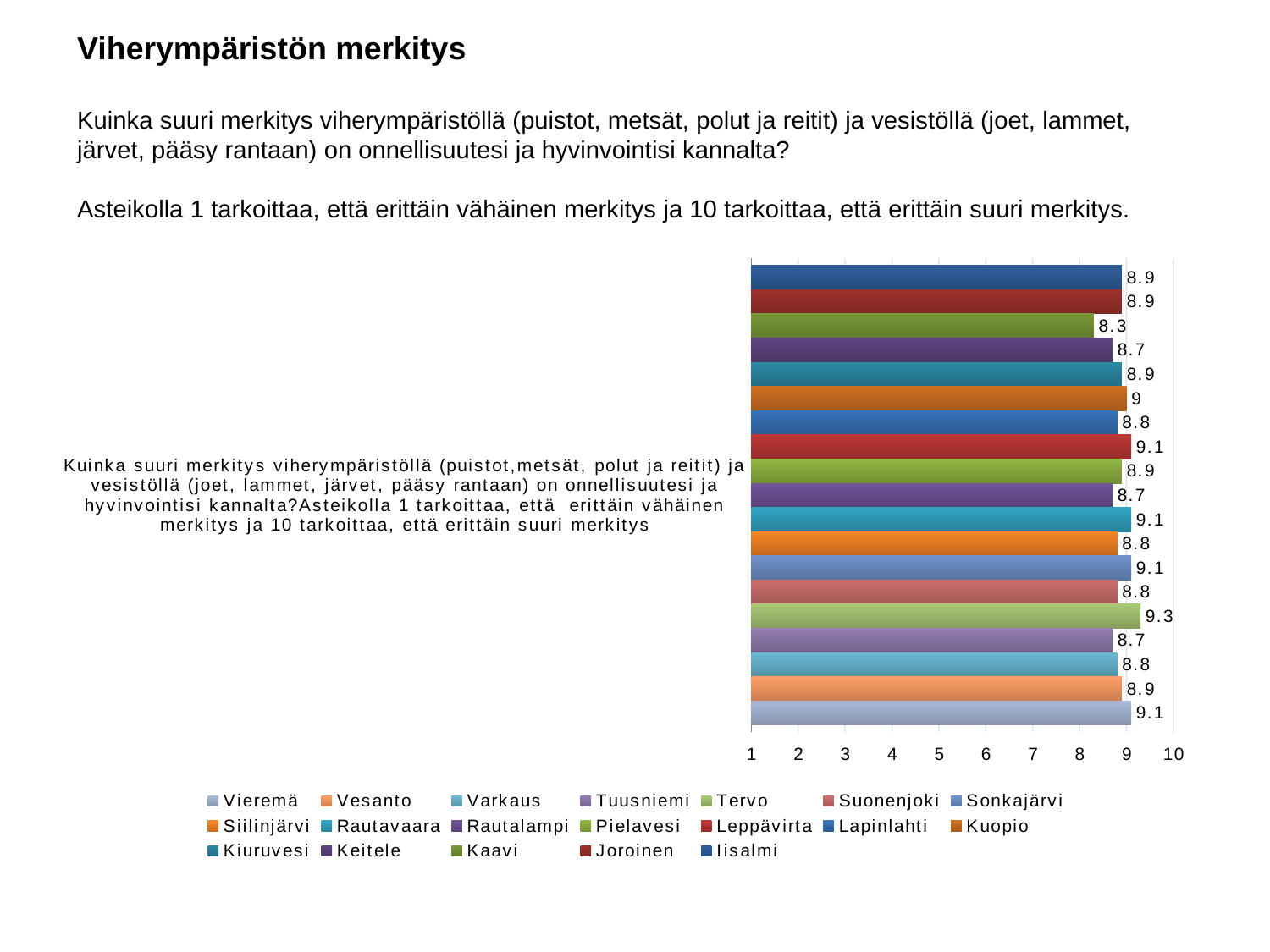
Which municipality has the highest value? Tervo What is the value for Iisalmi? 8.9 What is the difference between the values for Tervo and Kaavi? 1 Which is larger, the value for Kuopio or the value for Kaavi? Kuopio How many series does the legend list? 19 Which municipality has the lowest value? Kaavi What is the highest value shown on the horizontal axis? 10 What kind of chart is shown on the slide? bar chart What is the value for Kuopio? 9 What is the value for Tervo? 9.3 How many bars are plotted in the chart? 19 What is the value for Kaavi? 8.3